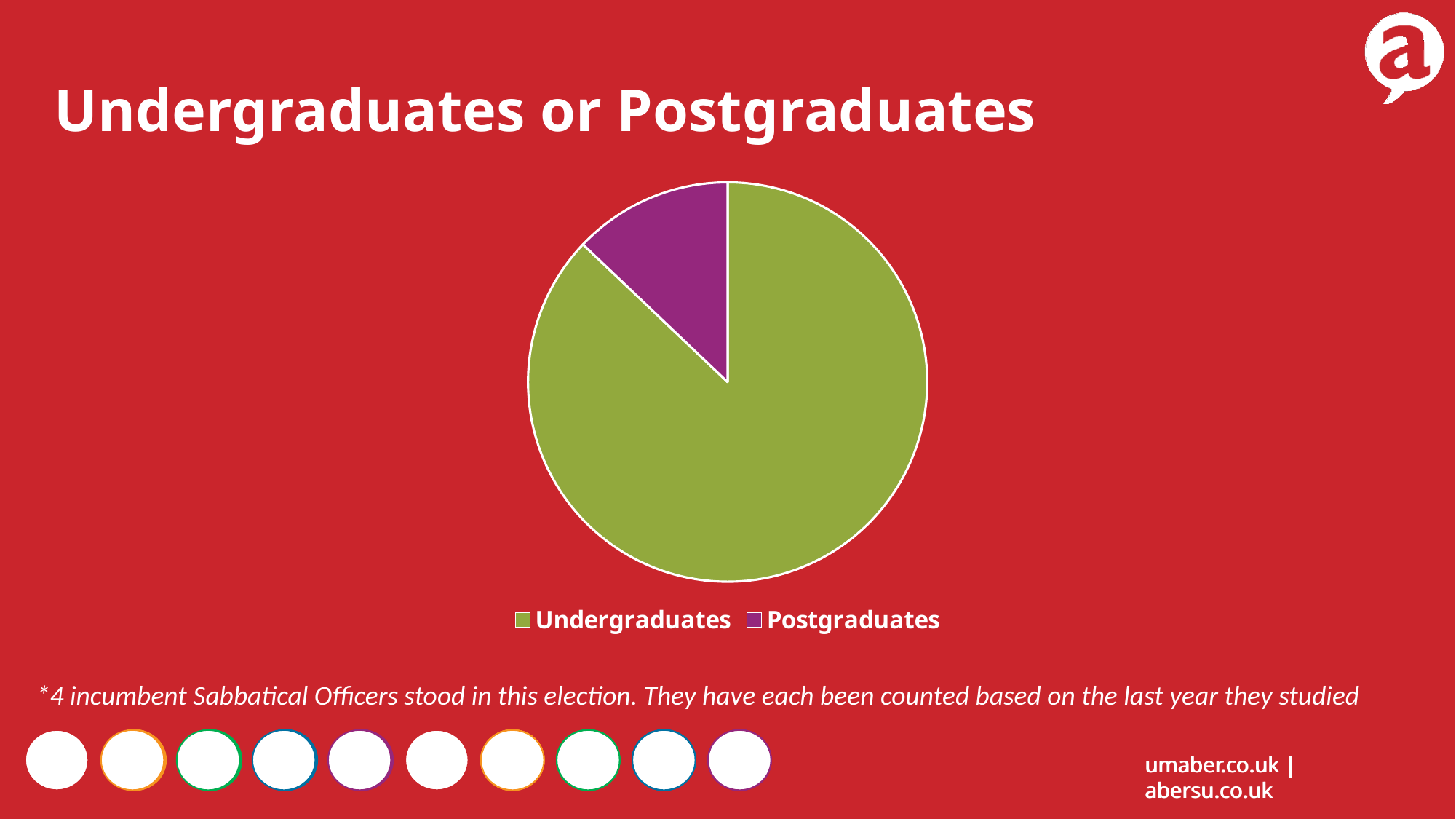
What colour is the Postgraduates slice? purple How many slices does the pie chart have? 2 How many entries does the legend list? 2 Which category has the largest slice of the pie? Undergraduates Which slice is larger, Undergraduates or Postgraduates? Undergraduates What kind of chart is shown on the slide? pie chart Which category has the smallest slice of the pie? Postgraduates What colour is the Undergraduates slice? green